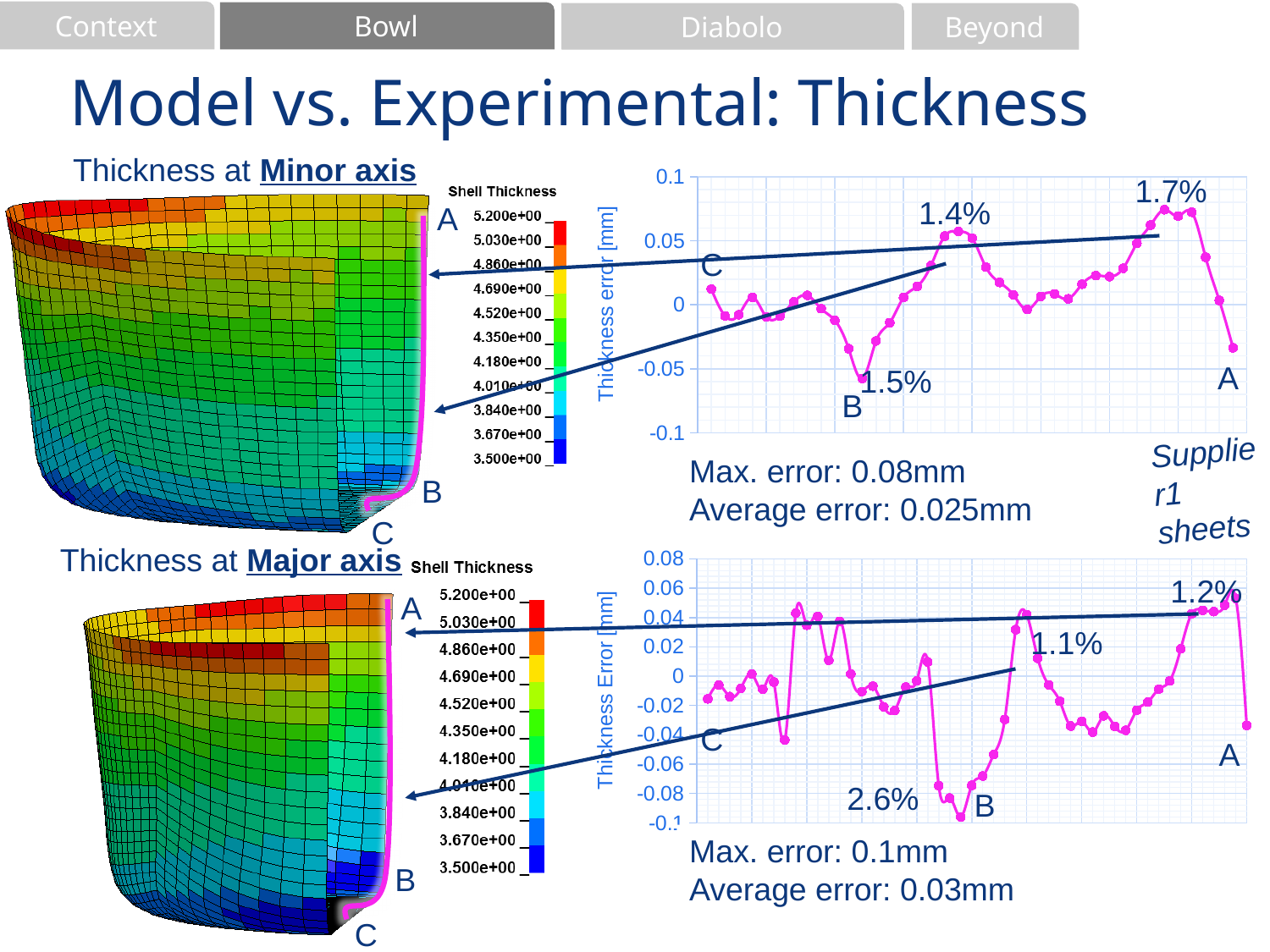
In the bottom chart (Thickness at Major axis), is the value at point B greater or less than -0.05? less According to the text under the top chart (Minor axis), what is the maximum error? 0.08mm In the top chart (Thickness at Minor axis), which percentage annotation is the largest? 1.7% What is the y-axis label of the top chart (Thickness at Minor axis)? Thickness error [mm] In the bottom chart (Thickness at Major axis), which percentage annotation is the largest? 2.6% In the top chart (Thickness at Minor axis), is the peak labelled 1.7% greater or less than 0.05? greater In the top chart (Thickness at Minor axis), is the value at point B greater or less than 0? less According to the text under the top chart (Minor axis), what is the average error? 0.025mm What kind of chart is the top chart (Thickness at Minor axis)? line chart In the top chart (Thickness at Minor axis), what is the maximum value shown on the y axis? 0.1 According to the text under the bottom chart (Major axis), what is the maximum error? 0.1mm According to the text under the bottom chart (Major axis), what is the average error? 0.03mm